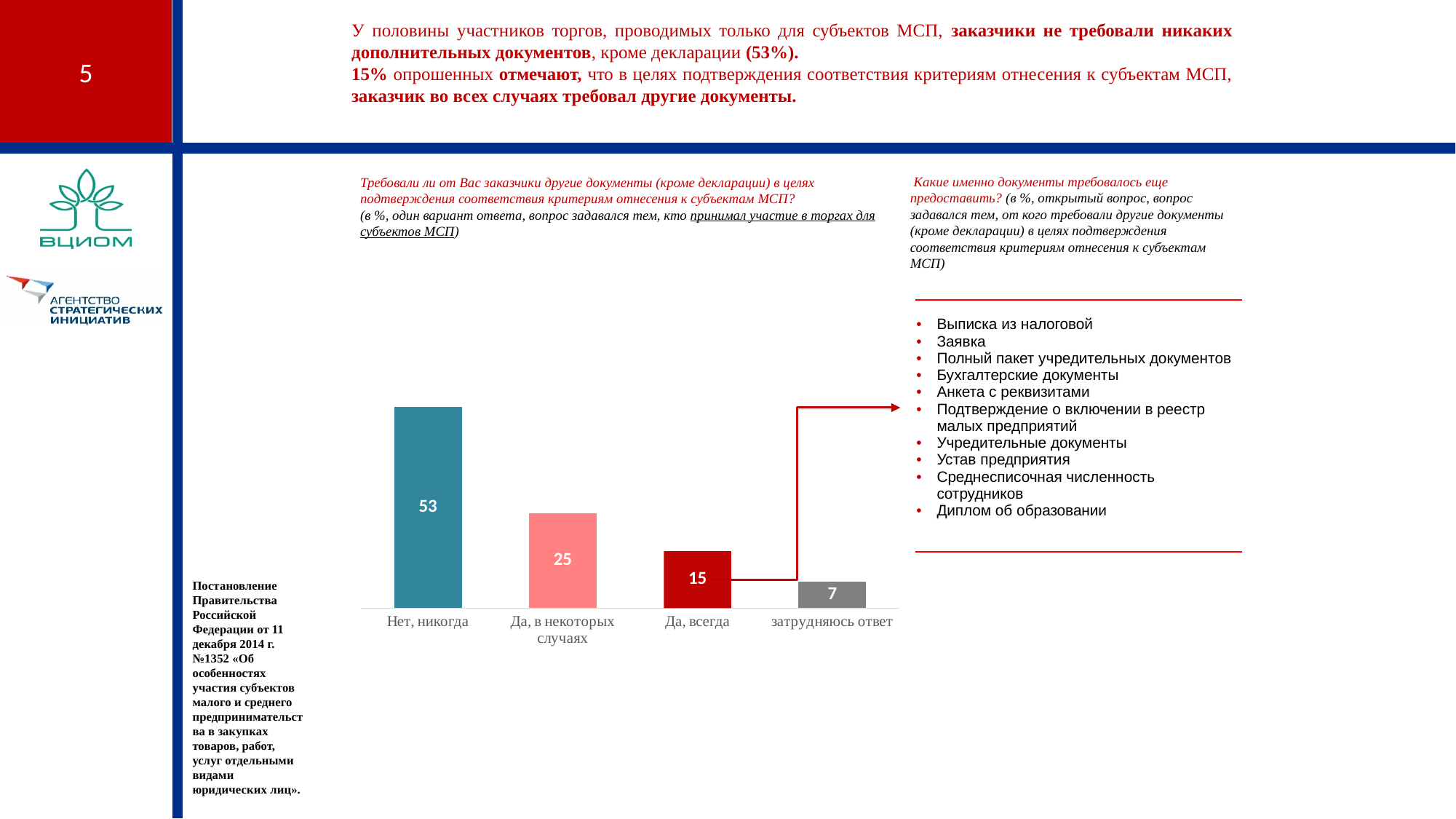
What is the difference between the values for "Нет, никогда" and "Да, в некоторых случаях"? 28 What is the difference between the values for "Да, всегда" and "затрудняюсь ответ"? 8 What is the value for "Да, всегда"? 15 What is the value for "Да, в некоторых случаях"? 25 What kind of chart is shown on the slide? Bar chart Which is larger: the value for "Да, в некоторых случаях" or the value for "Да, всегда"? Да, в некоторых случаях Do the values rise or fall from left to right along the x axis? Fall How many categories are shown in the chart? 4 What is the value for "Нет, никогда"? 53 Which category has the highest value? Нет, никогда Which category has the lowest value? затрудняюсь ответ What is the value for "затрудняюсь ответ"? 7